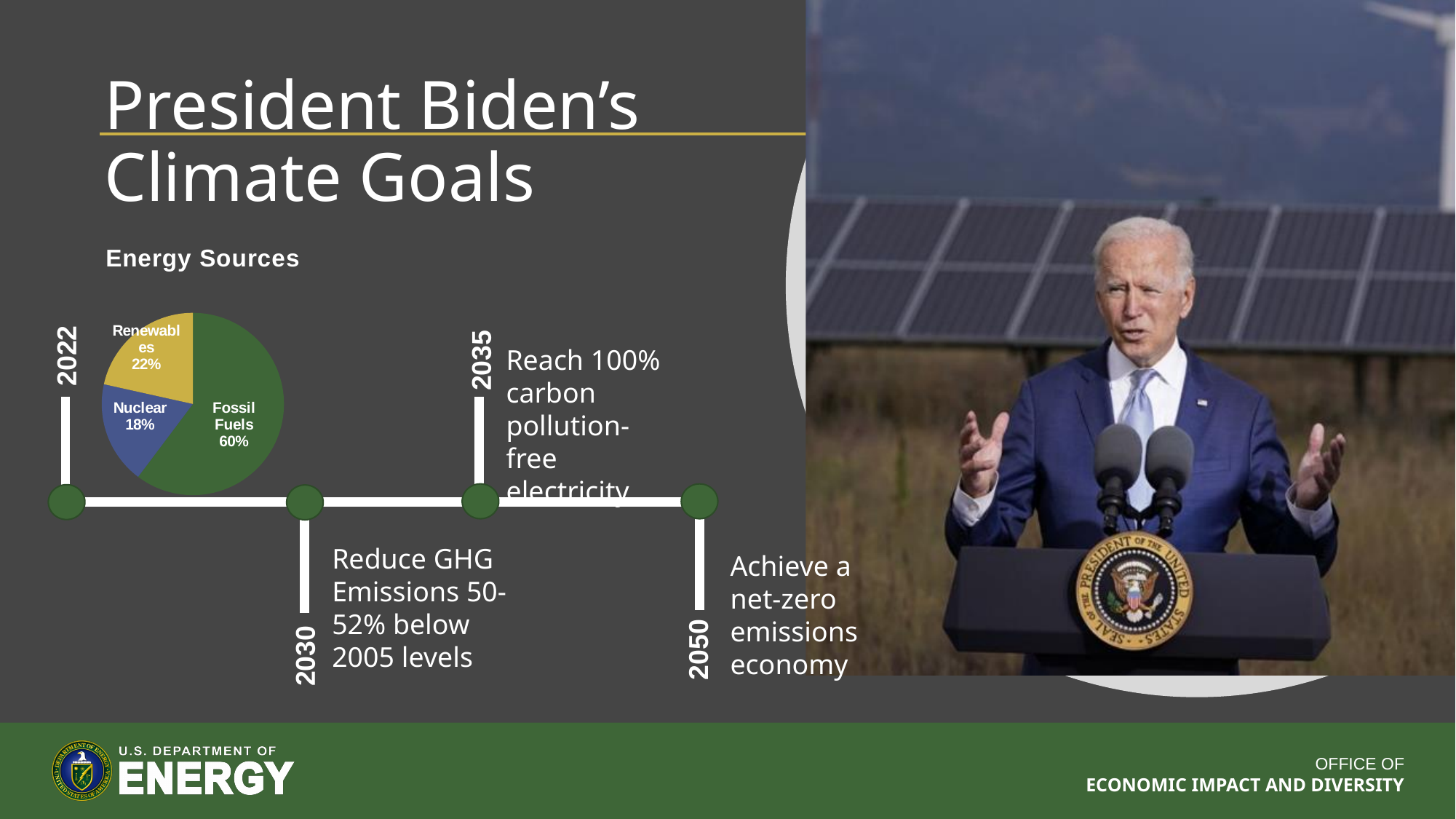
What share of the Energy Sources pie is Fossil Fuels? 60% Which year on the timeline is the Energy Sources pie chart placed above? 2022 In the Energy Sources pie chart, which is larger: Renewables or Nuclear? Renewables In the Energy Sources pie chart, what is the difference in percentage points between Fossil Fuels and Renewables? 38 Which slice of the Energy Sources pie chart is the smallest? Nuclear Which slice of the Energy Sources pie chart is the largest? Fossil Fuels What share of the Energy Sources pie is Nuclear? 18% In the Energy Sources pie chart, what is the difference in percentage points between Renewables and Nuclear? 4 How many slices does the Energy Sources pie chart have? 3 What share of the Energy Sources pie is Renewables? 22% What colour is the Fossil Fuels slice in the Energy Sources pie chart? Green What kind of chart is shown under the heading "Energy Sources"? Pie chart